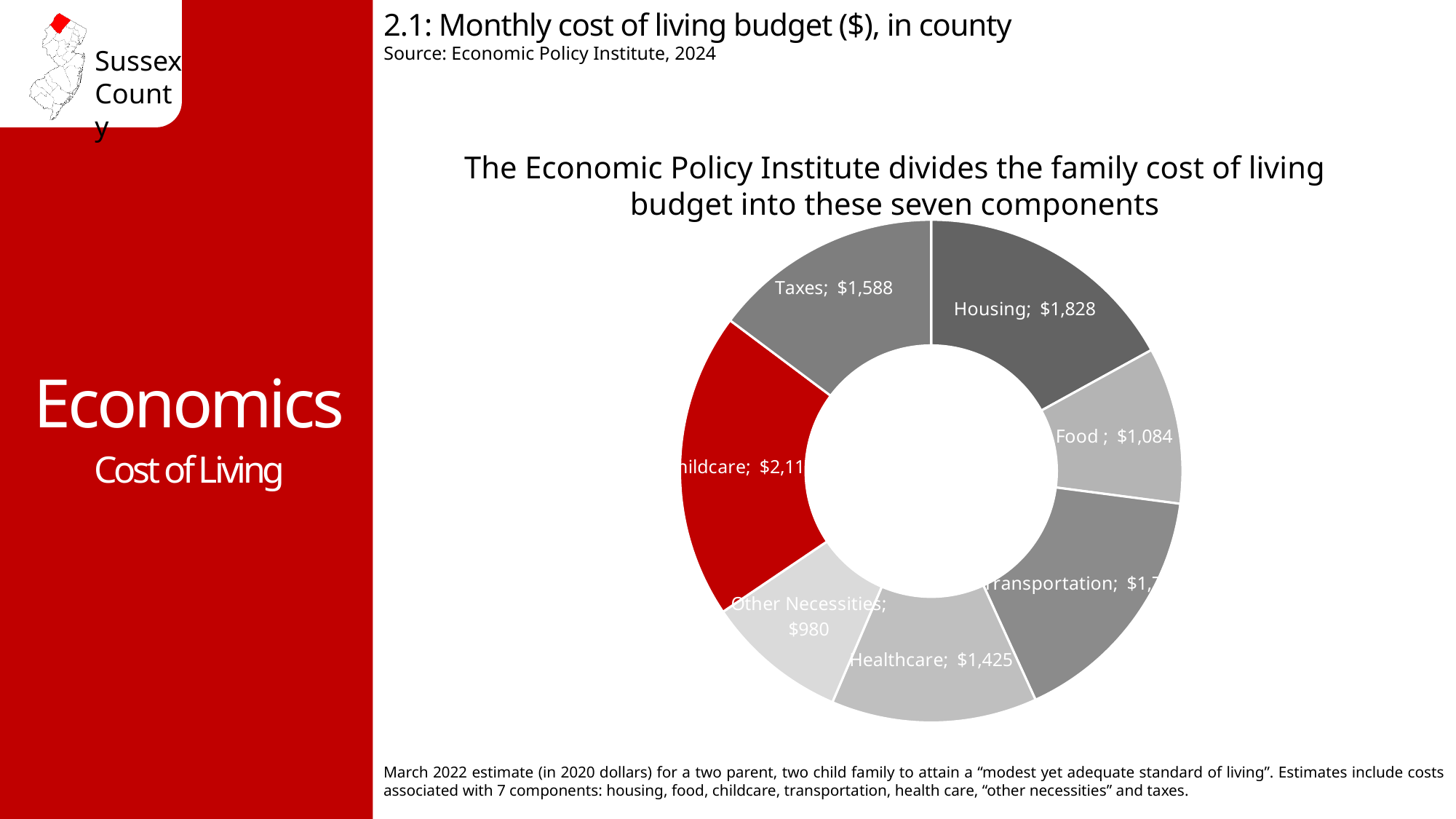
What is the monthly cost for Housing shown on the chart? $1,828 Which component has the largest monthly cost in the chart? Childcare What is the monthly cost for Food shown on the chart? $1,084 How much larger is the Housing cost than the Taxes cost? $240 Which component has the smallest monthly cost in the chart? Other Necessities What kind of chart is shown on the slide? Doughnut (pie) chart Which is larger, the Healthcare cost or the Food cost? Healthcare How many components are shown in the chart? 7 What is the monthly cost for Taxes shown on the chart? $1,588 What is the monthly cost for Other Necessities shown on the chart? $980 What is the monthly cost for Healthcare shown on the chart? $1,425 Which component's slice is coloured red in the chart? Childcare